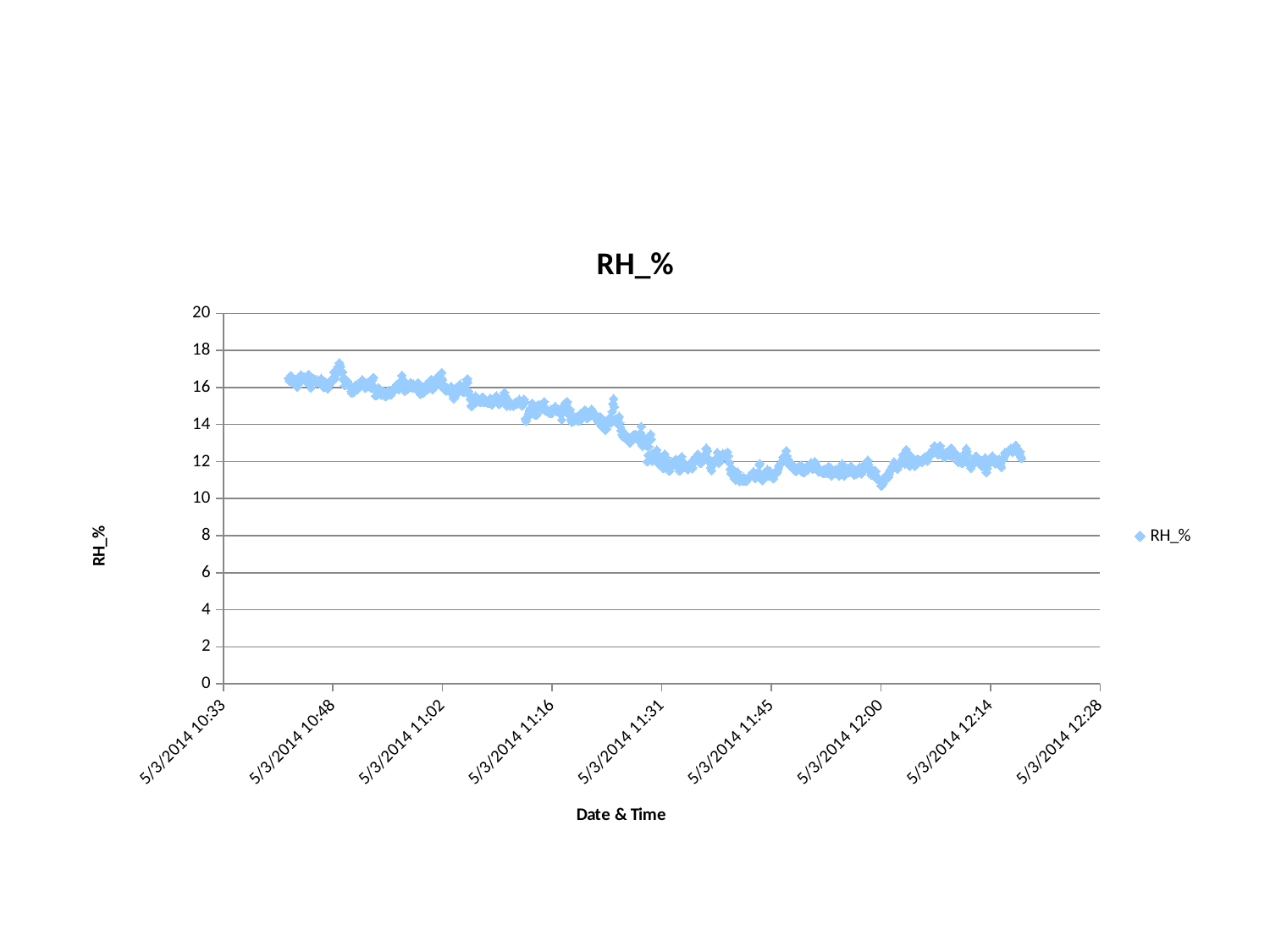
What is the label on the x axis of the chart? Date & Time Is the RH_% value at 5/3/2014 11:45 greater or less than 14? less Do the RH_% values generally rise or fall from left to right along the x axis? fall What is the title of the chart? RH_% Is the RH_% value at 5/3/2014 11:31 greater or less than 16? less Which of the two times has the higher RH_% value: 5/3/2014 10:48 or 5/3/2014 12:00? 5/3/2014 10:48 Is the RH_% value at 5/3/2014 12:14 greater or less than 10? greater How many series does the legend list? 1 What kind of chart is shown on the slide? scatter chart